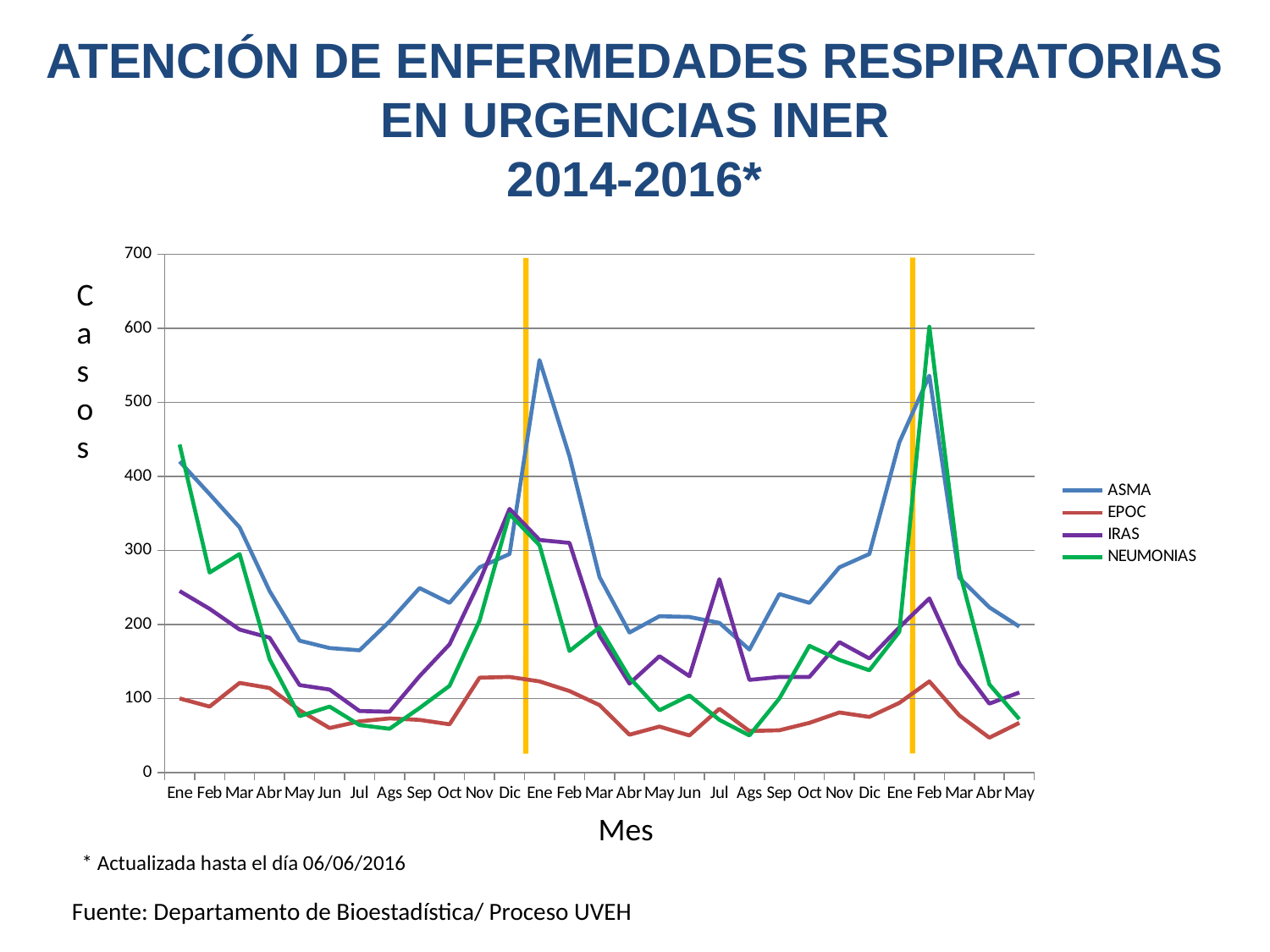
At Ene 2015, which is larger, ASMA or NEUMONIAS? ASMA How many series does the legend list? 4 At Jul 2015, which is larger, IRAS or EPOC? IRAS How many monthly points are plotted along the x axis? 29 Which series is drawn in green? NEUMONIAS Does the ASMA line rise or fall from Ene 2014 to May 2014? fall What is the label of the x axis? Mes Is the ASMA value at the first Ene peak (Ene 2015) greater or less than 500? greater Is the NEUMONIAS value at Feb 2016 greater or less than 500? greater Is the EPOC value at Abr 2015 greater or less than 100? less What kind of chart is shown on the slide? line chart